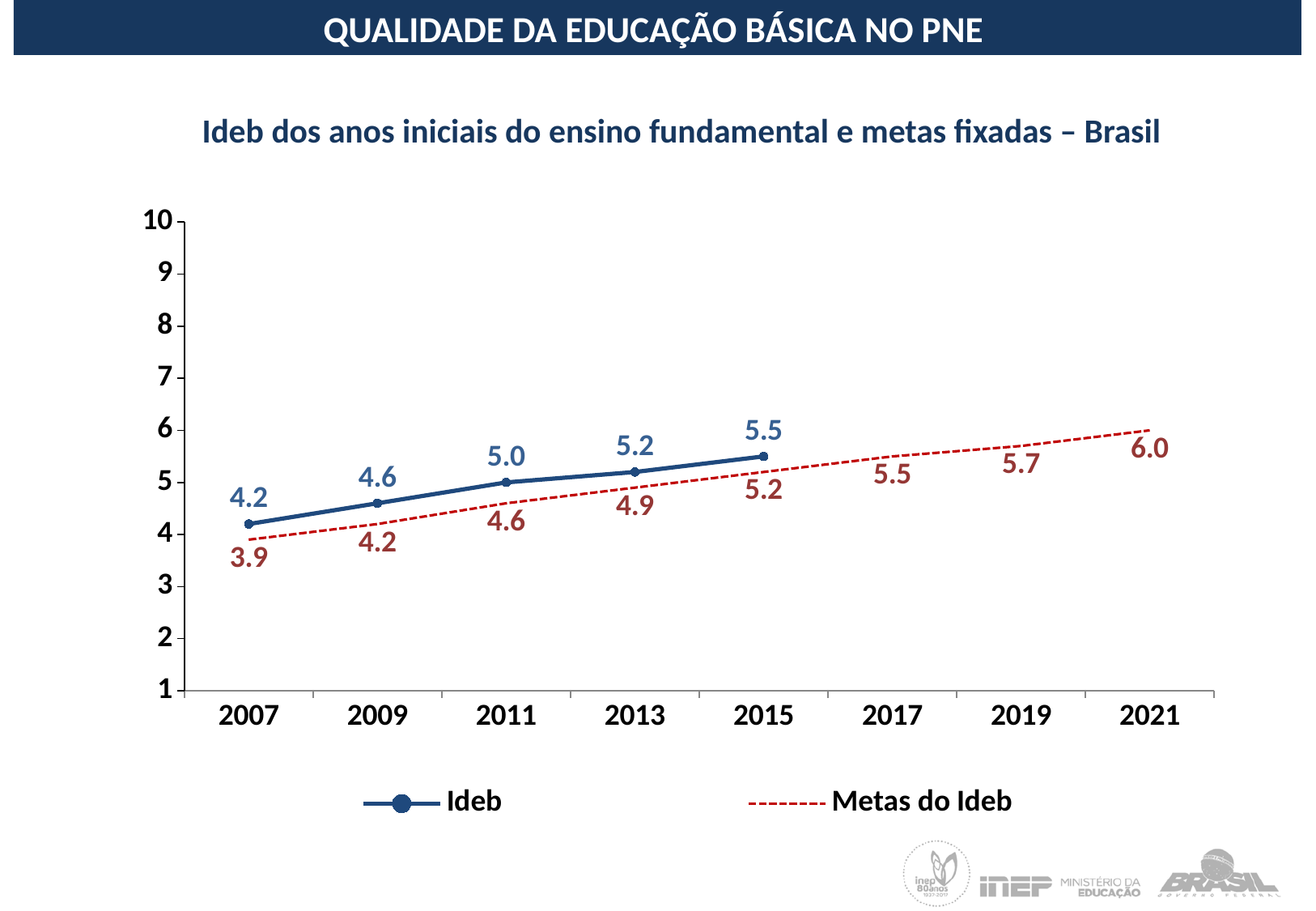
Does the Ideb series rise or fall from 2007 to 2015? Rise In which year is the Metas do Ideb series lowest? 2007 What is the Metas do Ideb value for 2007? 3.9 How many years are shown on the x axis? 8 What is the difference between the Ideb value and the Metas do Ideb value in 2013? 0.3 What is the Metas do Ideb value for 2021? 6.0 What is the Ideb value for 2015? 5.5 What kind of chart is shown? Line chart How many series does the legend list? 2 Which is larger in 2009, the Ideb value or the Metas do Ideb value? Ideb In which year is the Ideb series highest? 2015 What is the Ideb value for 2011? 5.0